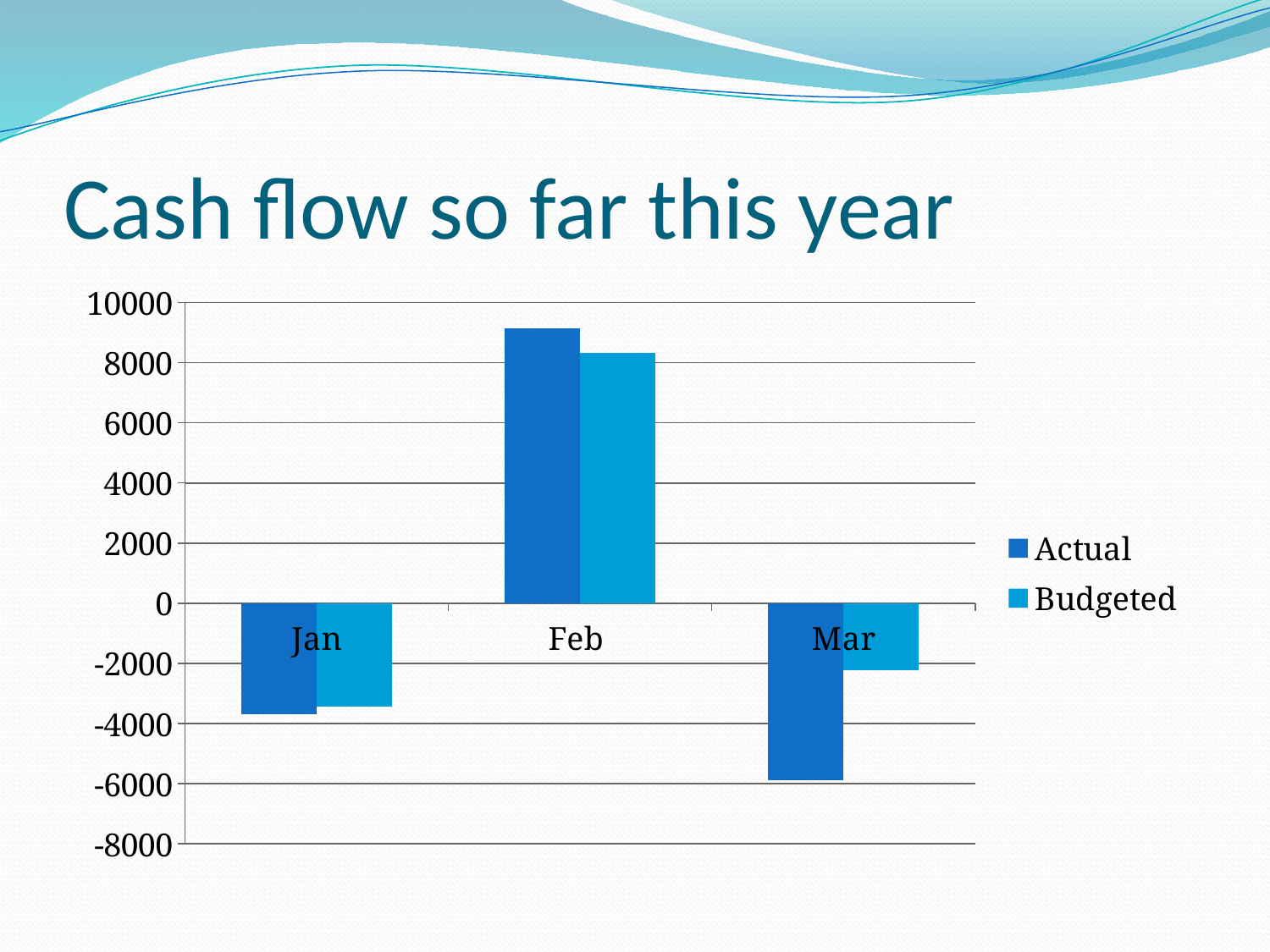
Is the Actual value for Mar greater or less than -4000? less How many series does the legend list? 2 Is the Actual value for Feb greater or less than 8000? greater Is the Budgeted value for Mar greater or less than -4000? greater What is the title of the chart? Cash flow so far this year How many months are shown on the x axis? 3 Which month has the lowest Actual cash flow? Mar In Mar, which is larger, the Actual or the Budgeted value? Budgeted What kind of chart is shown on the slide? bar chart Which month has the highest Actual cash flow? Feb In Feb, which is larger, the Actual or the Budgeted value? Actual